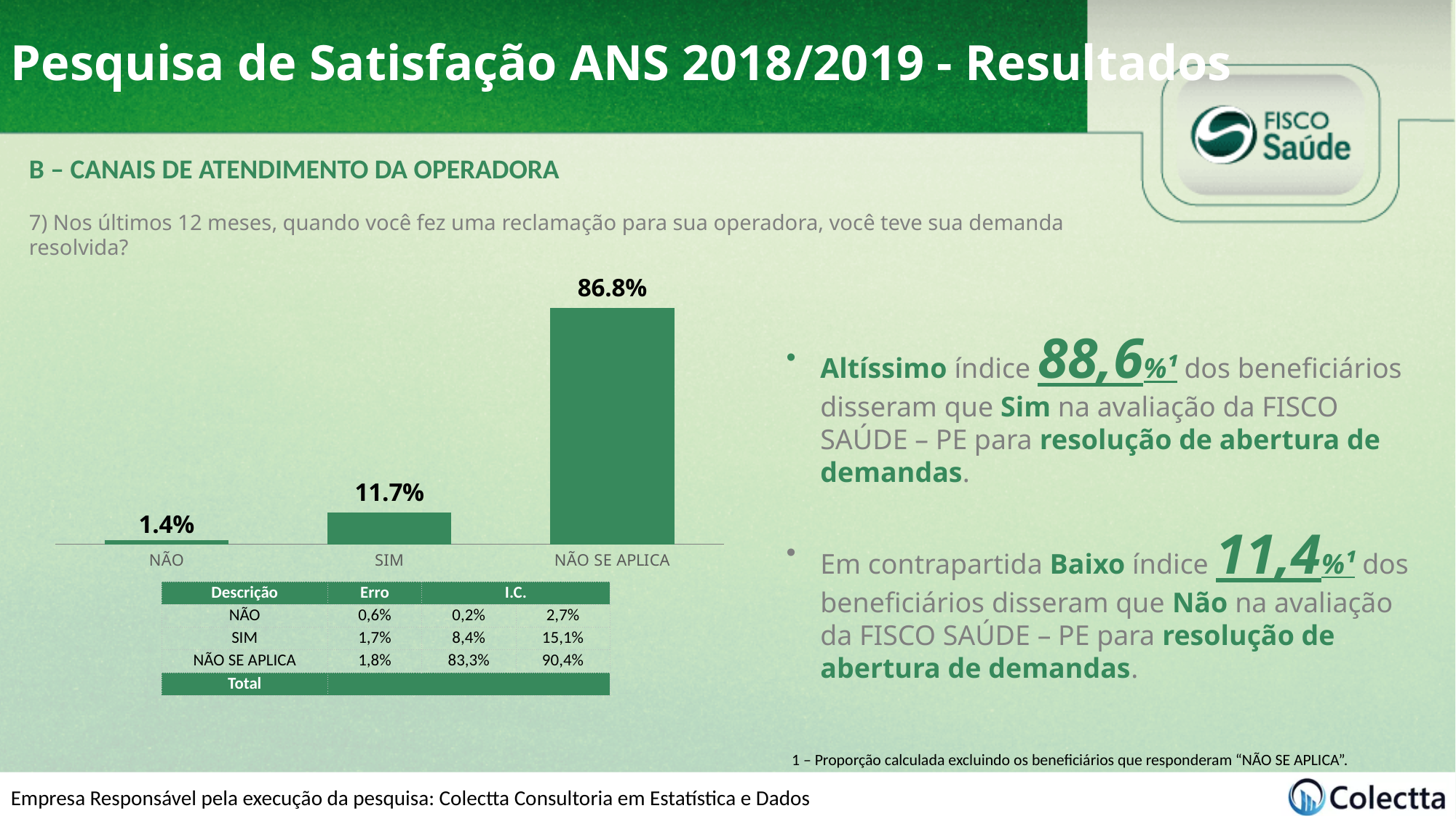
Do the values rise or fall from left to right across the categories in the bar chart? Rise What is the difference between the values for SIM and NÃO? 10.3% What is the value for NÃO in the bar chart? 1.4% Which survey question number does the chart on the slide refer to? 7 Which category has the highest value in the bar chart? NÃO SE APLICA What is the value for NÃO SE APLICA in the bar chart? 86.8% Which category has the lowest value in the bar chart? NÃO How many categories are shown in the bar chart? 3 What is the difference between the values for NÃO SE APLICA and SIM? 75.1% What is the value for SIM in the bar chart? 11.7% What kind of chart is shown on the slide? Bar chart Which is larger, the value for SIM or the value for NÃO? SIM